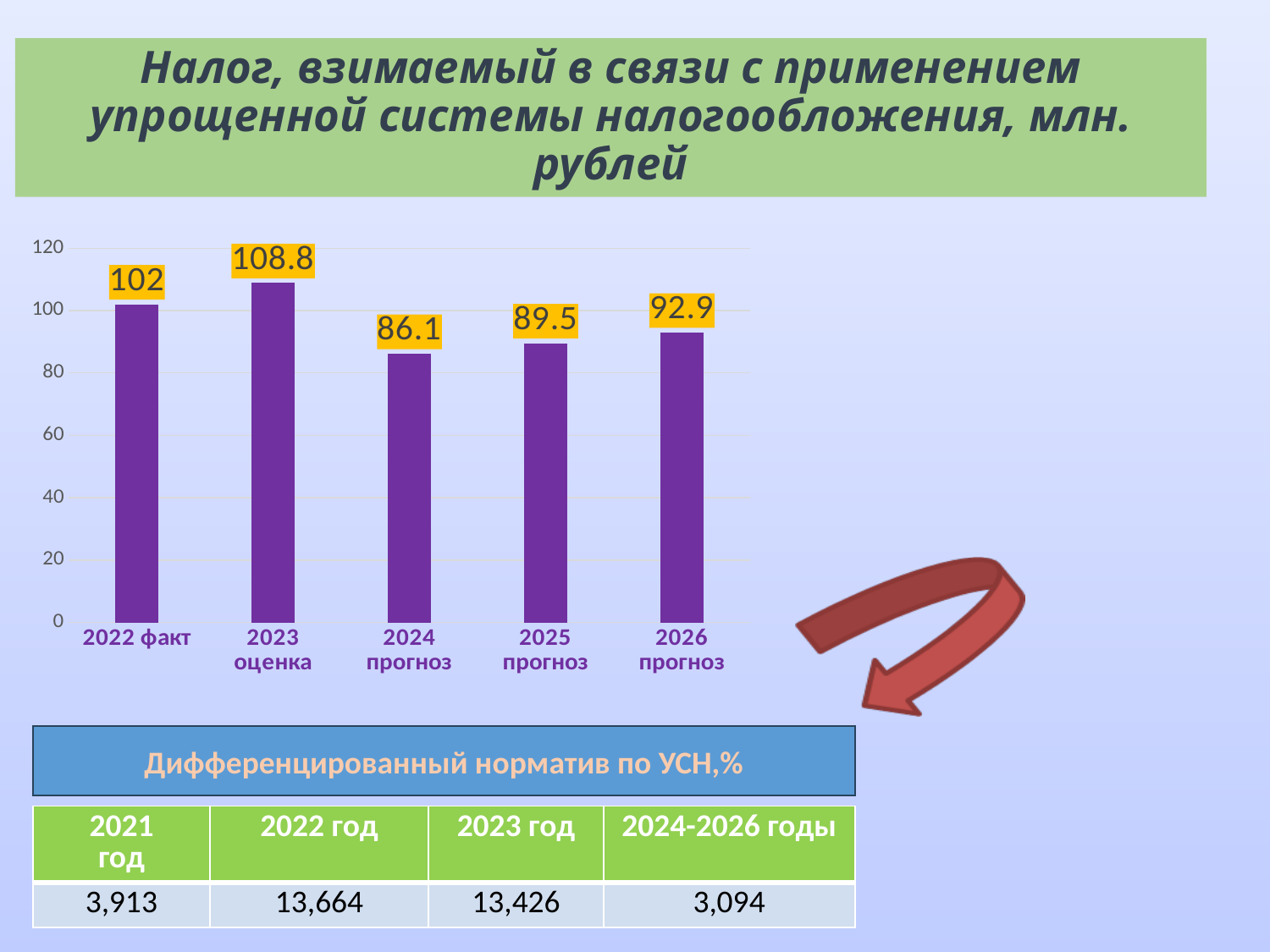
What kind of chart is shown on the slide? bar chart Which is larger, the value for 2022 факт or the value for 2025 прогноз? 2022 факт What is the difference between the values for 2026 прогноз and 2025 прогноз? 3.4 What is the difference between the values for 2023 оценка and 2024 прогноз? 22.7 What is the value for 2024 прогноз? 86.1 Which category has the lowest value? 2024 прогноз Do the values rise or fall from 2024 прогноз to 2026 прогноз? rise How many bars are shown in the chart? 5 Is the value for 2025 прогноз greater or less than 100? less Which category has the highest value? 2023 оценка What is the value for 2022 факт? 102 What is the value for 2026 прогноз? 92.9